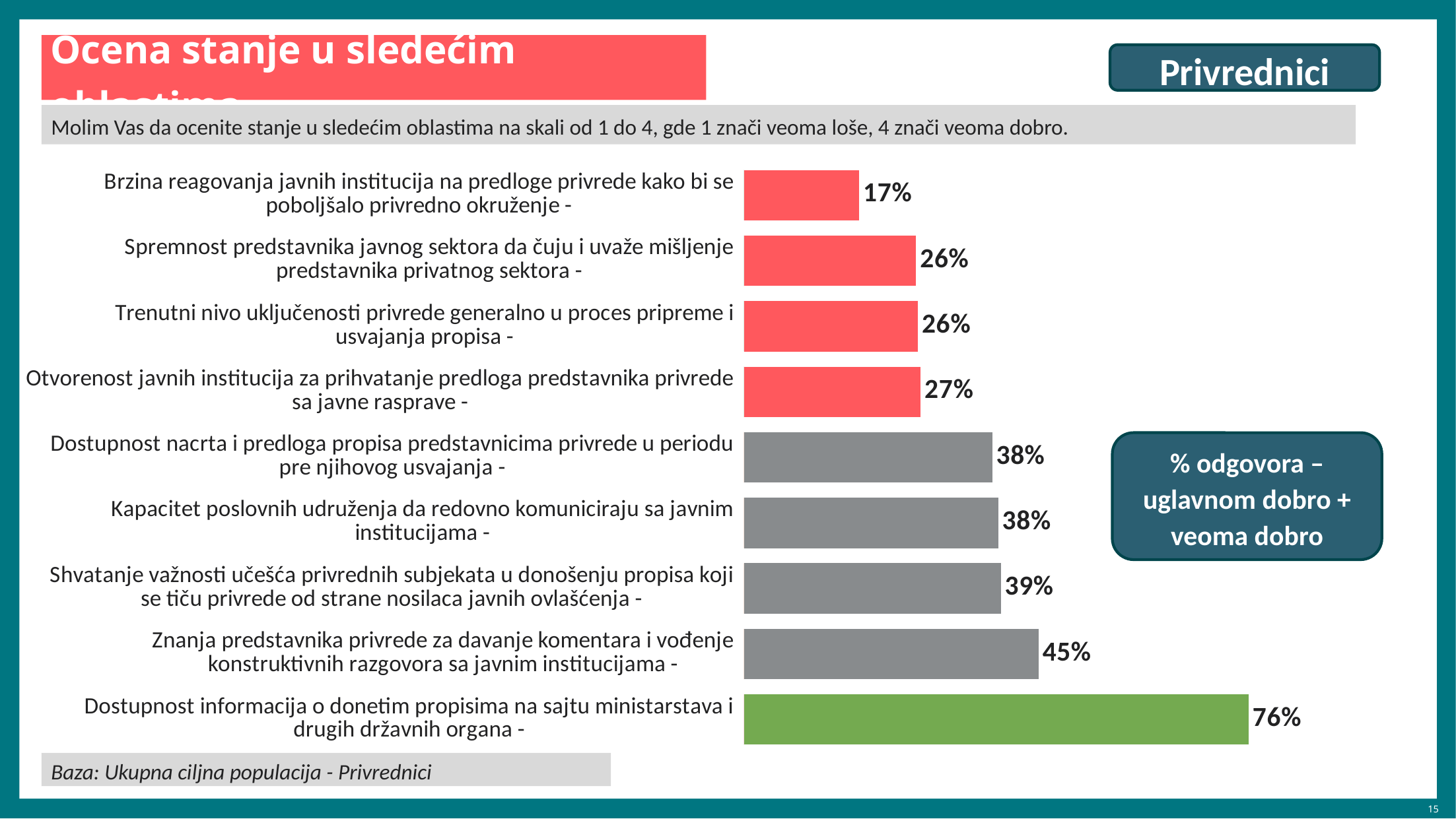
What is the value for "Brzina reagovanja javnih institucija na predloge privrede kako bi se poboljšalo privredno okruženje"? 17% What is the difference between "Znanja predstavnika privrede..." (45%) and "Shvatanje važnosti učešća privrednih subjekata..." (39%)? 6 percentage points What is the value for "Dostupnost informacija o donetim propisima na sajtu ministarstava i drugih državnih organa"? 76% What is the value for "Otvorenost javnih institucija za prihvatanje predloga predstavnika privrede sa javne rasprave"? 27% Which category has the lowest value? Brzina reagovanja javnih institucija na predloge privrede kako bi se poboljšalo privredno okruženje What colour is the bar for the category with the highest value? Green What is the difference between the highest value (76%) and the lowest value (17%)? 59 percentage points What is the value for "Znanja predstavnika privrede za davanje komentara i vođenje konstruktivnih razgovora sa javnim institucijama"? 45% Which category has the highest value? Dostupnost informacija o donetim propisima na sajtu ministarstava i drugih državnih organa How many categories are shown in the chart? 9 Which is larger: the value for "Dostupnost nacrta i predloga propisa..." or the value for "Otvorenost javnih institucija..."? Dostupnost nacrta i predloga propisa... What kind of chart is shown on the slide? Bar chart